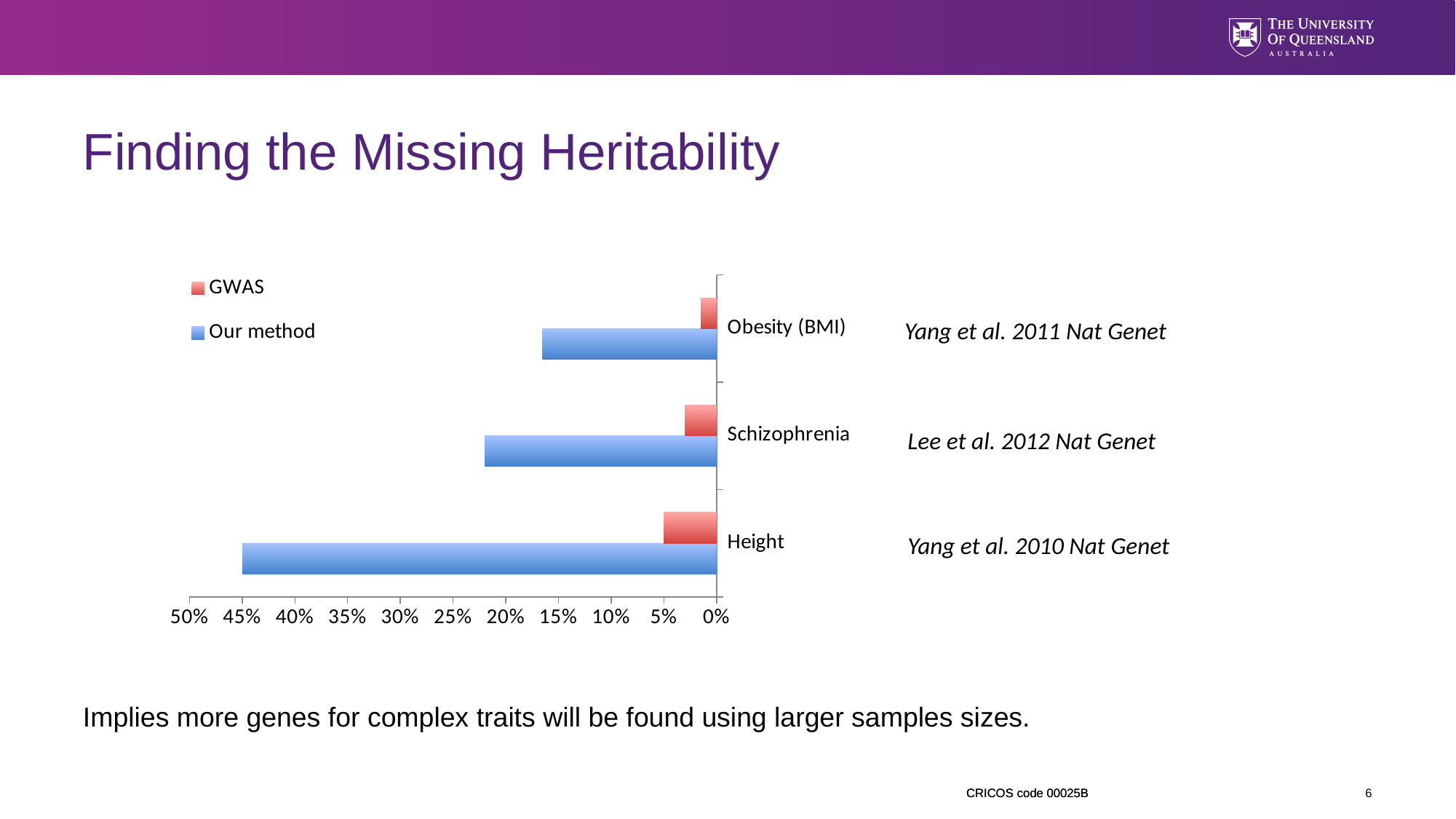
What colour are the GWAS bars in the chart? red How many traits (categories) are plotted in the chart? 3 What kind of chart is shown on the slide? bar chart Which trait has the lowest value for the 'Our method' series? Obesity (BMI) What is the GWAS value for Height? 5% Is the 'Our method' value for Schizophrenia greater or less than 20%? greater How many series does the chart legend list? 2 For Height, which series has the larger value, GWAS or Our method? Our method Is the 'Our method' value for Obesity (BMI) greater or less than 20%? less Which trait has the highest value for the GWAS series? Height Which trait has the highest value for the 'Our method' series? Height What is the value of 'Our method' for Height? 45%